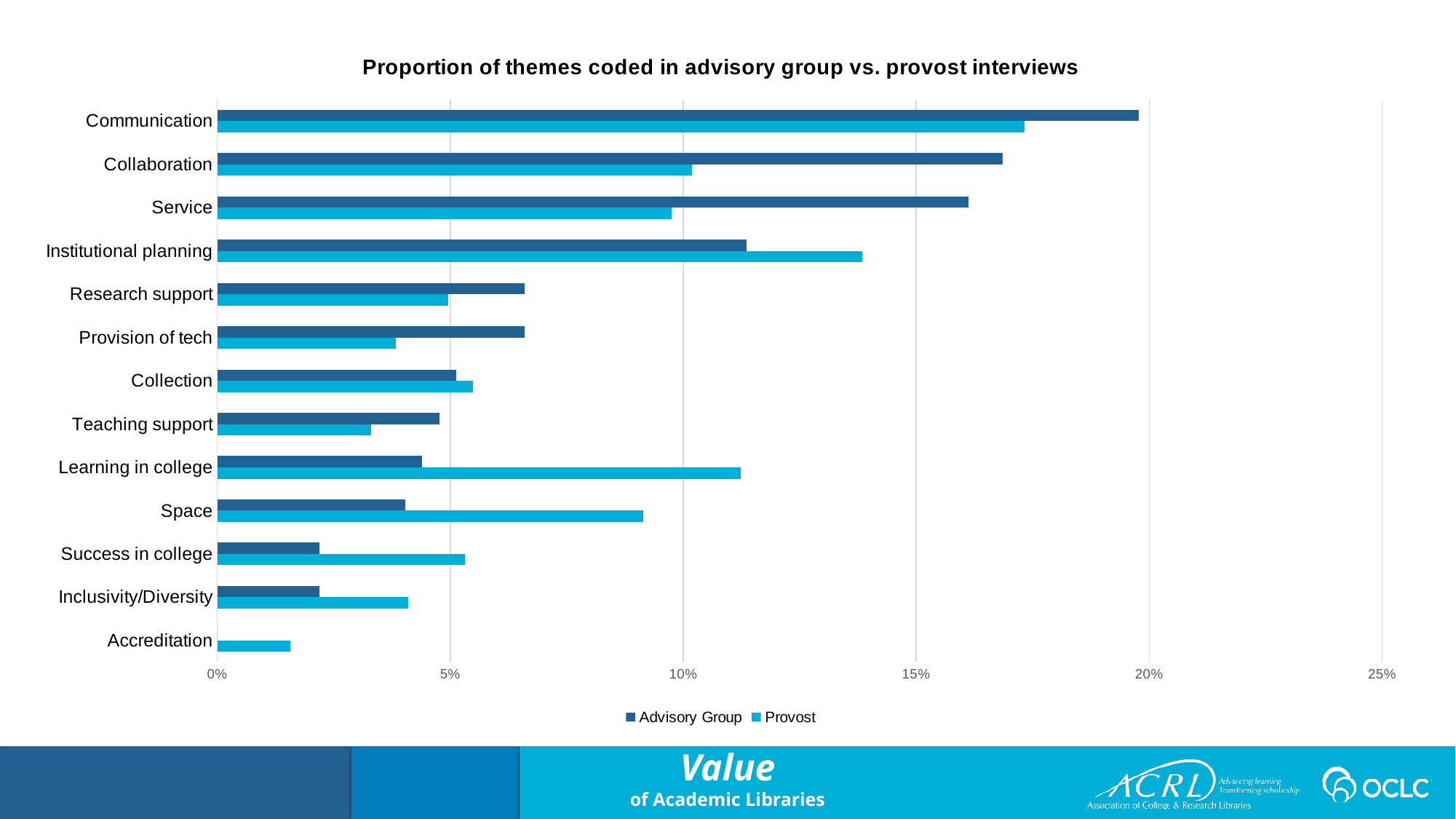
For Institutional planning, which series has the larger value, Advisory Group or Provost? Provost Which theme has the highest Provost value? Communication Which theme has the lowest Provost value? Accreditation For Collaboration, which series has the larger value, Advisory Group or Provost? Advisory Group Which theme has the highest Advisory Group value? Communication What kind of chart is shown on the slide? bar chart Is the Advisory Group value for Success in college greater or less than 5%? less How many theme categories are plotted on the chart? 13 Is the Provost value for Institutional planning greater or less than 10%? greater Is the Provost value for Space greater or less than 10%? less How many series does the legend list? 2